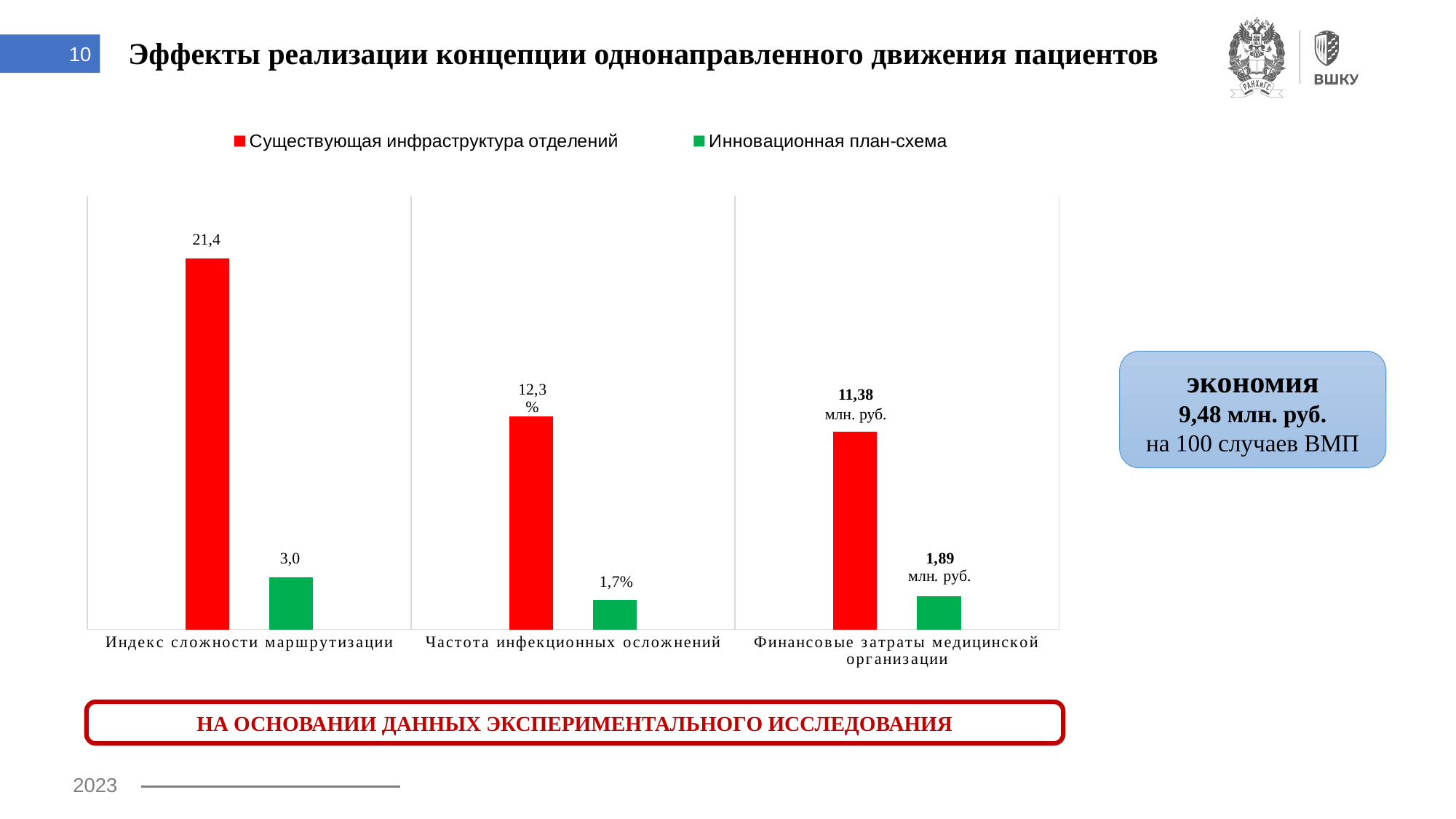
What is the value for Существующая инфраструктура отделений in the category Финансовые затраты медицинской организации? 11,38 млн. руб. Which colour represents the series Инновационная план-схема in the chart? green What is the value for Инновационная план-схема in the category Частота инфекционных осложнений? 1,7% What is the difference between the two series in the category Индекс сложности маршрутизации? 18,4 How many series does the legend list? 2 How many categories are shown on the x axis of the chart? 3 What is the value for Инновационная план-схема in the category Финансовые затраты медицинской организации? 1,89 млн. руб. What is the value for Существующая инфраструктура отделений in the category Индекс сложности маршрутизации? 21,4 Which series has the larger value in the category Частота инфекционных осложнений? Существующая инфраструктура отделений What is the value for Инновационная план-схема in the category Индекс сложности маршрутизации? 3,0 What kind of chart is shown on the slide? bar chart What is the value for Существующая инфраструктура отделений in the category Частота инфекционных осложнений? 12,3%